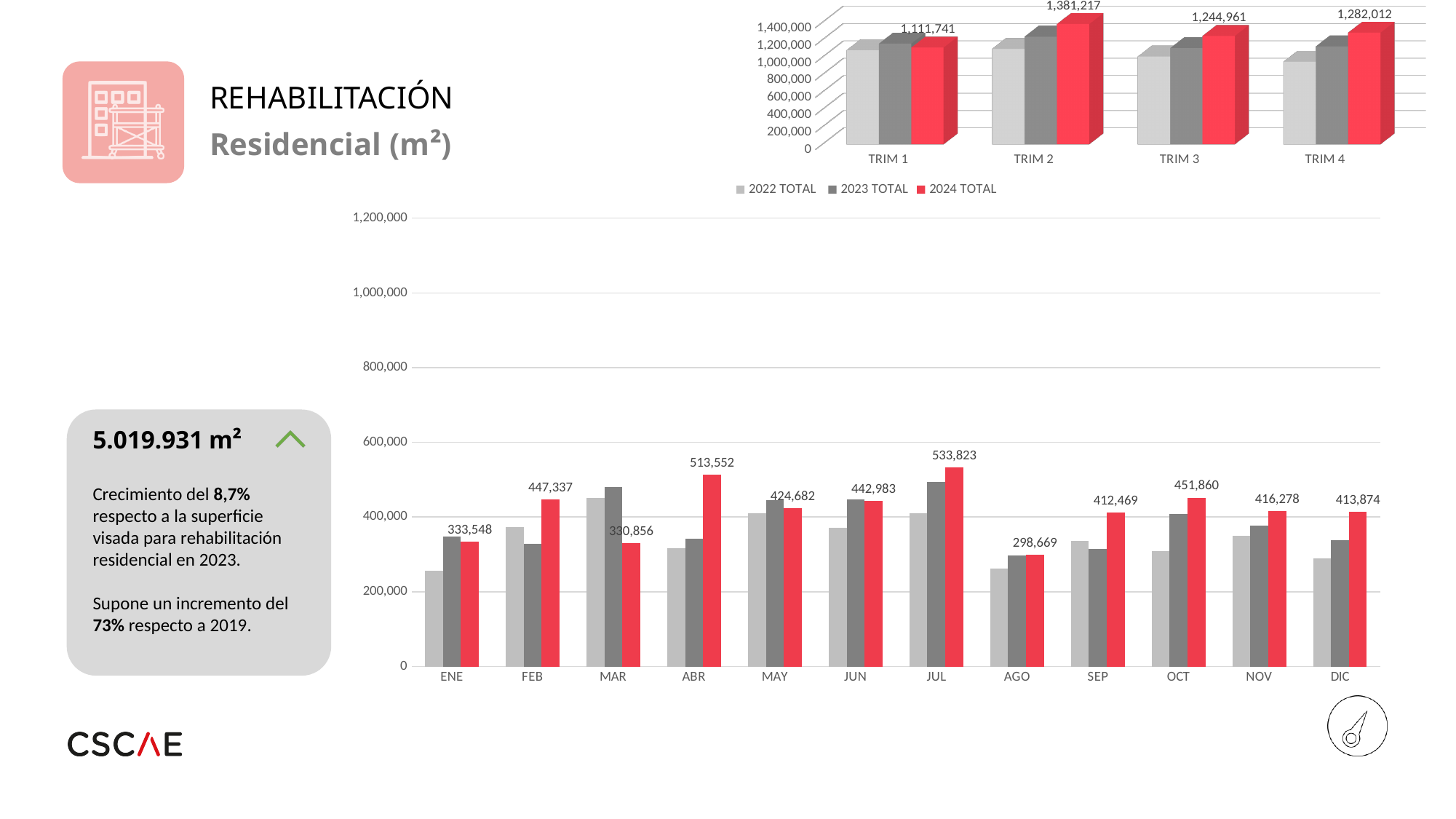
What kind of chart is the monthly chart? bar chart In the quarterly chart at the top right, how many series does the legend list? 3 In the monthly chart, what is the difference between the labelled values for JUL and AGO? 235,154 In the monthly chart, is the value of the light grey bar for ENE greater or less than 400,000? less In the quarterly chart at the top right, how many quarters are shown on the x axis? 4 In the monthly chart, which month has the highest labelled value? JUL In the monthly chart, what is the labelled value for JUL? 533,823 In the monthly chart, which month has the lowest labelled value? AGO In the quarterly chart at the top right, which quarter has the lowest 2024 TOTAL value? TRIM 1 In the monthly chart, is the labelled value for FEB or for MAR larger? FEB In the quarterly chart at the top right, what is the 2024 TOTAL value for TRIM 2? 1,381,217 In the quarterly chart at the top right, what is the difference between the 2024 TOTAL values for TRIM 2 and TRIM 1? 269,476